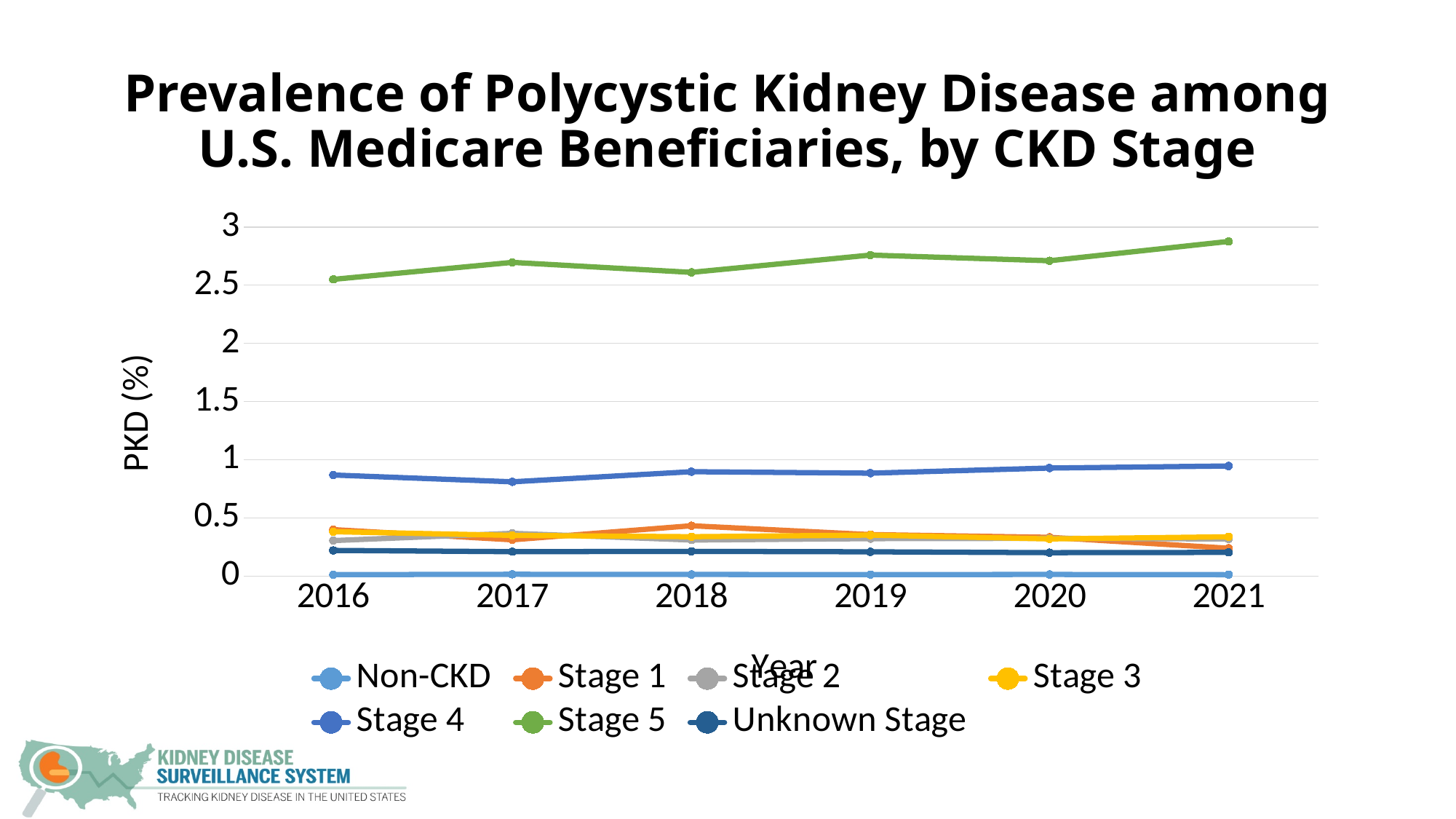
Is the value for Stage 5 in 2021 greater or less than 2.5? greater Does the Stage 5 line rise or fall overall from 2016 to 2021? rise Is the value for Stage 5 in 2016 greater or less than 2? greater What kind of chart is shown on the slide? line chart How many series does the legend list? 7 Is the value for Stage 4 in 2017 greater or less than 1? less What is the label on the y axis? PKD (%) Which series has the lowest PKD prevalence across all years? Non-CKD Which CKD stage has the highest PKD prevalence across all years? Stage 5 How many years are plotted along the x axis? 6 In 2018, which is larger: the value for Stage 4 or the value for Stage 1? Stage 4